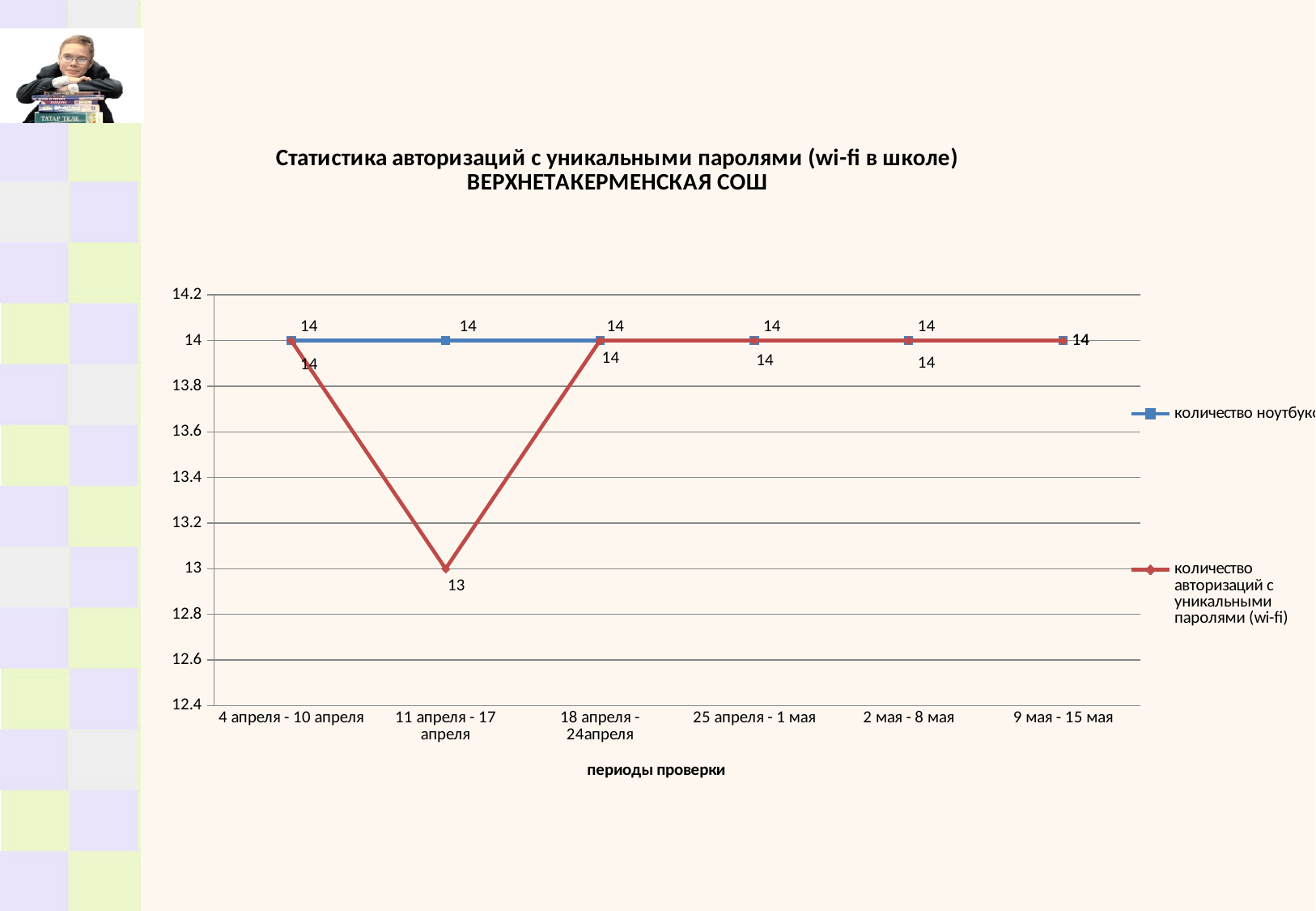
What is the value of the red series (количество авторизаций с уникальными паролями (wi-fi)) for the period 11 апреля - 17 апреля? 13 For the period 11 апреля - 17 апреля, which series has the larger value, the blue series or the red series? the blue series What is the label of the x axis? периоды проверки How many series does the legend list? 2 In which period is the red series (количество авторизаций с уникальными паролями (wi-fi)) lowest? 11 апреля - 17 апреля Is the value of the red series for 11 апреля - 17 апреля greater or less than 13.4? less What kind of chart is shown on the slide? line chart Does the red series rise or fall between 11 апреля - 17 апреля and 18 апреля - 24апреля? rise How many periods are plotted along the x axis? 6 What is the difference between the blue series and the red series for the period 11 апреля - 17 апреля? 1 What is the value of the blue series for the period 9 мая - 15 мая? 14 What is the value of the red series (количество авторизаций с уникальными паролями (wi-fi)) for the period 4 апреля - 10 апреля? 14